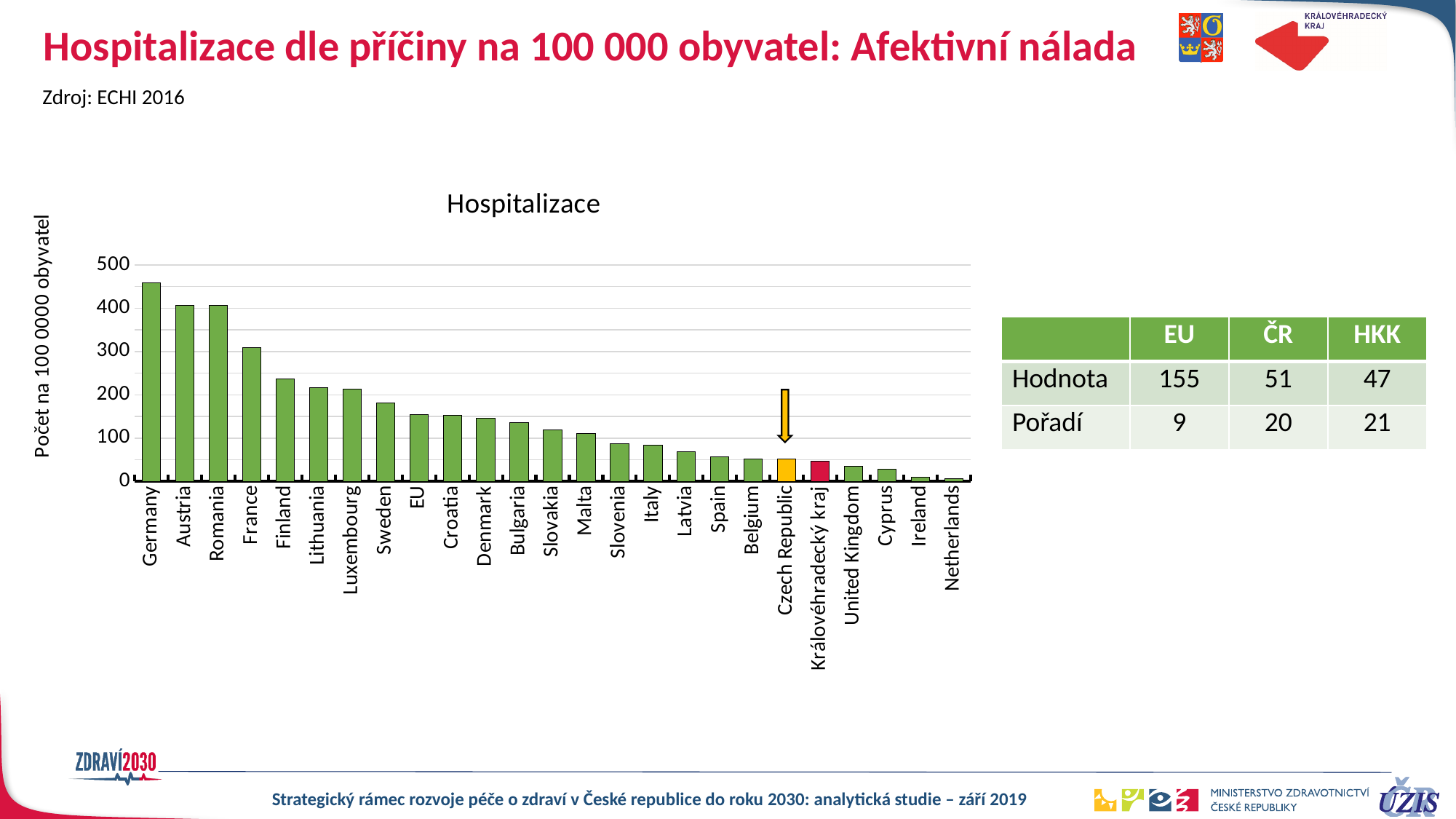
Which category has the lowest value in the chart? Netherlands How many categories (bars) are plotted in the chart? 25 What is the value for Královéhradecký kraj (HKK) according to the slide? 47 What is the difference between the EU value and the ČR value? 104 What is the title of the chart? Hospitalizace Which category has the highest value in the chart? Germany Is the value for Germany greater or less than 400? greater What is the value for the EU according to the slide? 155 Which is larger, the value for Czech Republic or the value for Královéhradecký kraj? Czech Republic What type of chart is shown on the slide? bar chart What is the value for the Czech Republic (ČR) according to the slide? 51 Do the values rise or fall from left to right along the x axis? fall